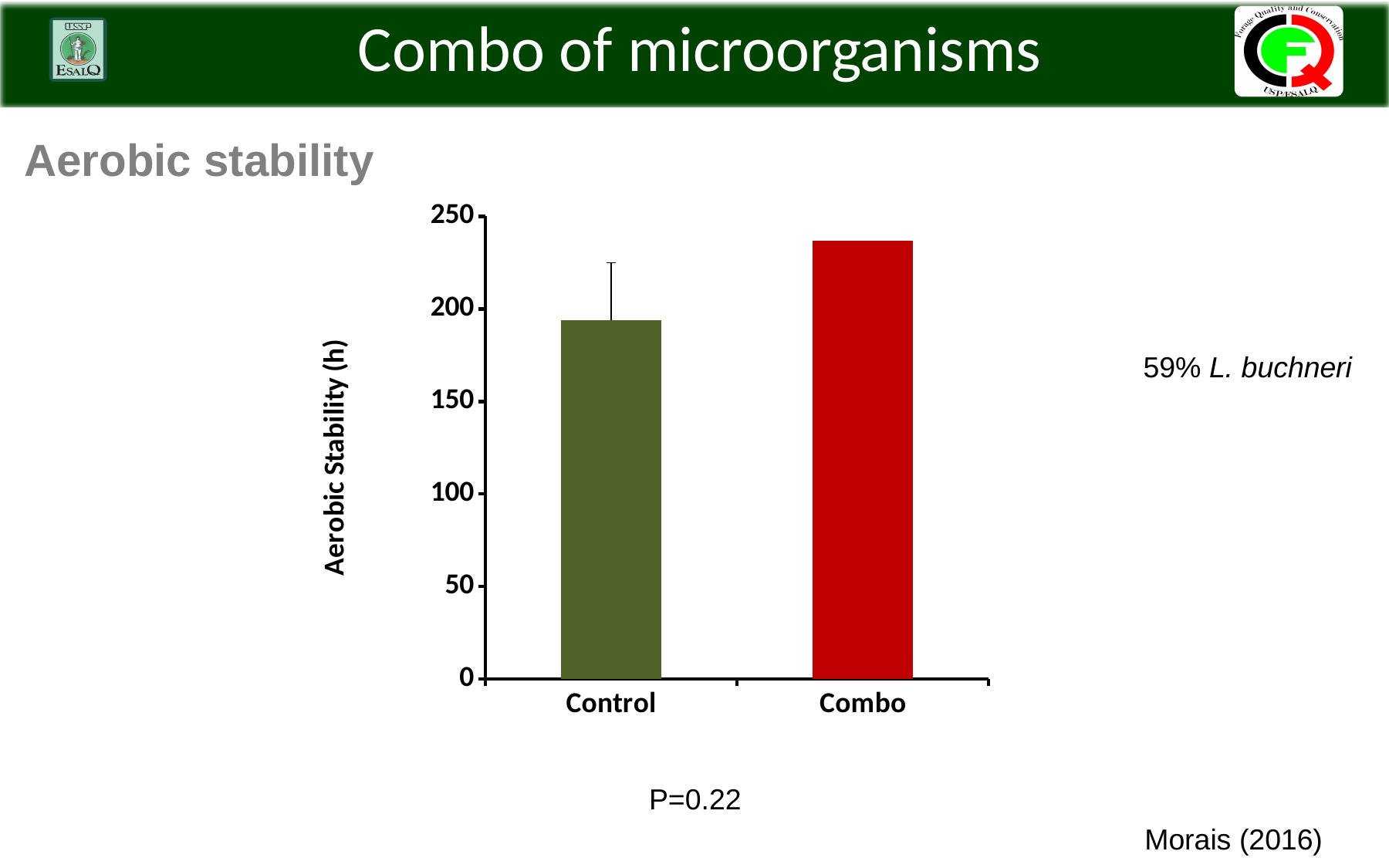
What kind of chart is shown on the slide? bar chart Is the value for Combo greater or less than 200? greater Which category has the lowest aerobic stability? Control What is the label of the y axis? Aerobic Stability (h) Which category has the higher aerobic stability, Control or Combo? Combo Is the value for Combo greater or less than 250? less What colour is the Combo bar? red Which category has the highest aerobic stability? Combo Is the value for Control greater or less than 150? greater Do the values rise or fall from Control to Combo along the x axis? rise How many categories are plotted on the x axis? 2